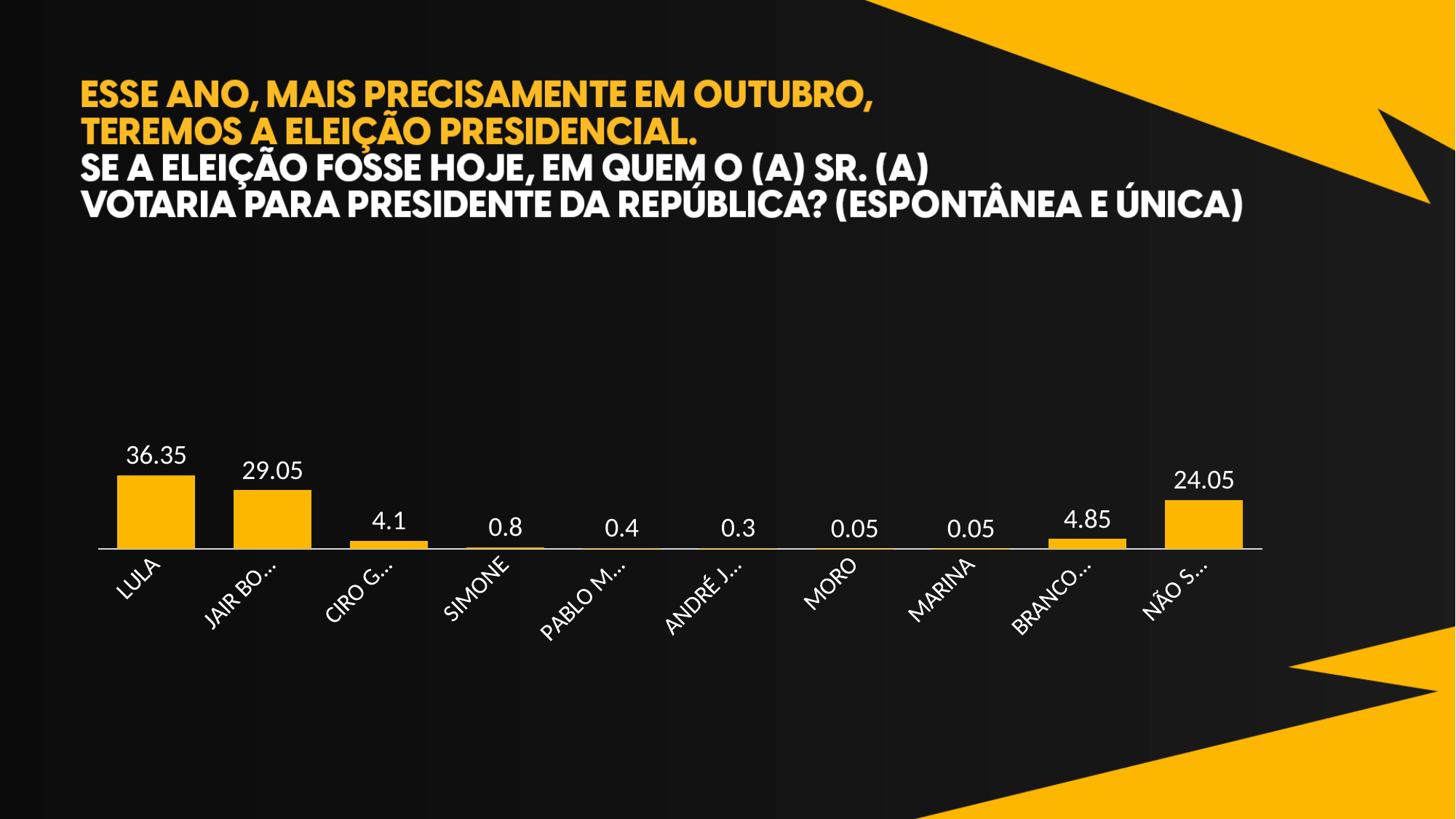
What value is shown for MORO? 0.05 What value is shown for LULA? 36.35 What kind of chart is shown on the slide? Bar chart What is the difference between the values for LULA and "JAIR BO…"? 7.3 Which has a larger value, SIMONE or MARINA? SIMONE What is the difference between the values for "BRANCO…" and "CIRO G…"? 0.75 What value is shown for SIMONE? 0.8 What value is shown for the bar labelled "NÃO S…"? 24.05 How many categories are shown on the chart? 10 Which category has the highest value? LULA Which has a larger value, "NÃO S…" or "CIRO G…"? NÃO S… What value is shown for the bar labelled "JAIR BO…"? 29.05